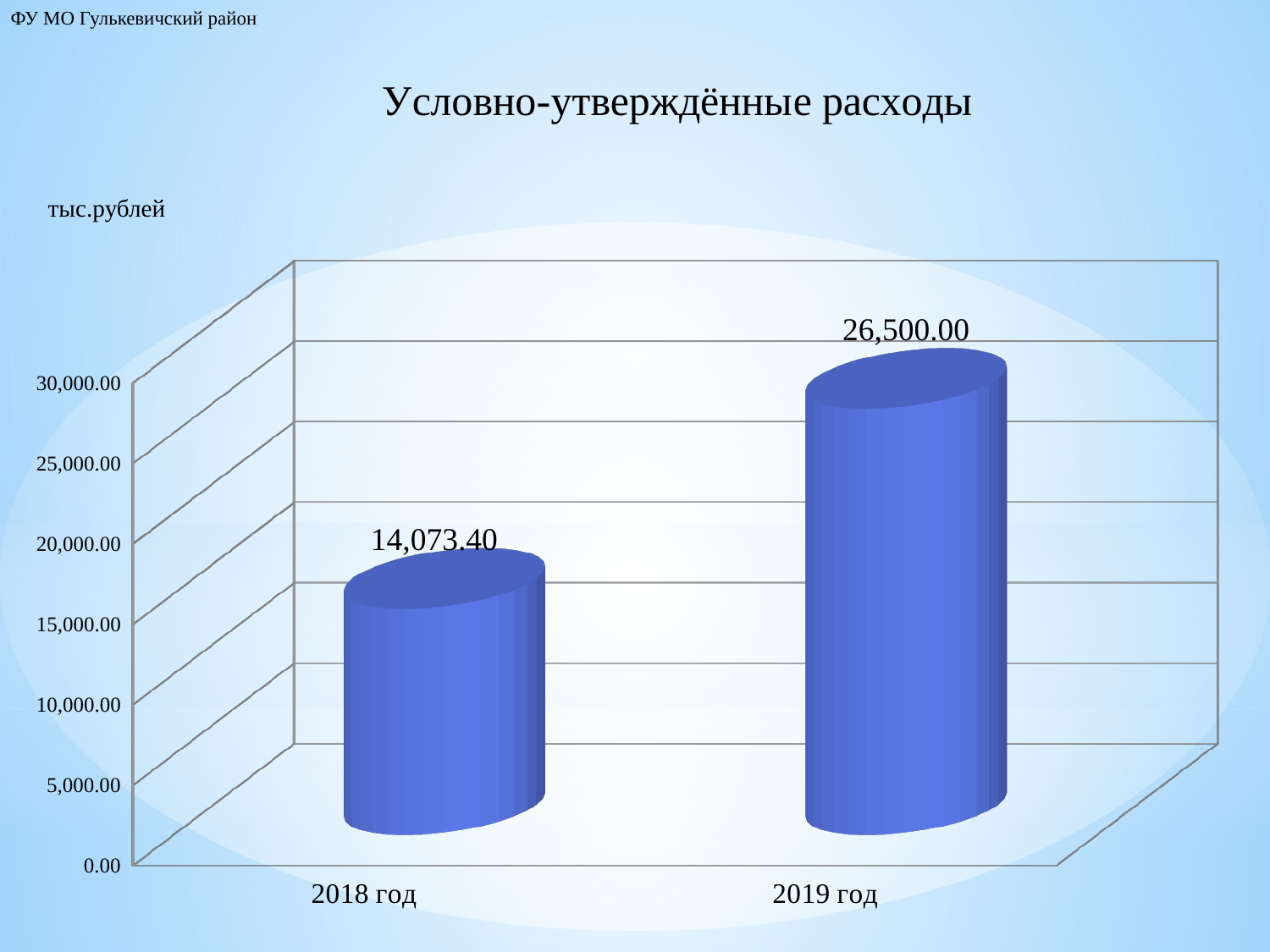
What kind of chart is shown on the slide? bar chart What is the title of the chart? Условно-утверждённые расходы What is the value for 2018 год? 14,073.40 Is the value for 2019 год greater or less than 25,000.00? greater Is the value for 2018 год greater or less than 15,000.00? less How many categories are shown on the chart? 2 What is the difference between the values for 2019 год and 2018 год? 12,426.60 Which year has the highest value? 2019 год Do the values rise or fall from 2018 год to 2019 год? rise What is the value for 2019 год? 26,500.00 Which year has the lowest value? 2018 год Which is larger, the value for 2018 год or the value for 2019 год? 2019 год